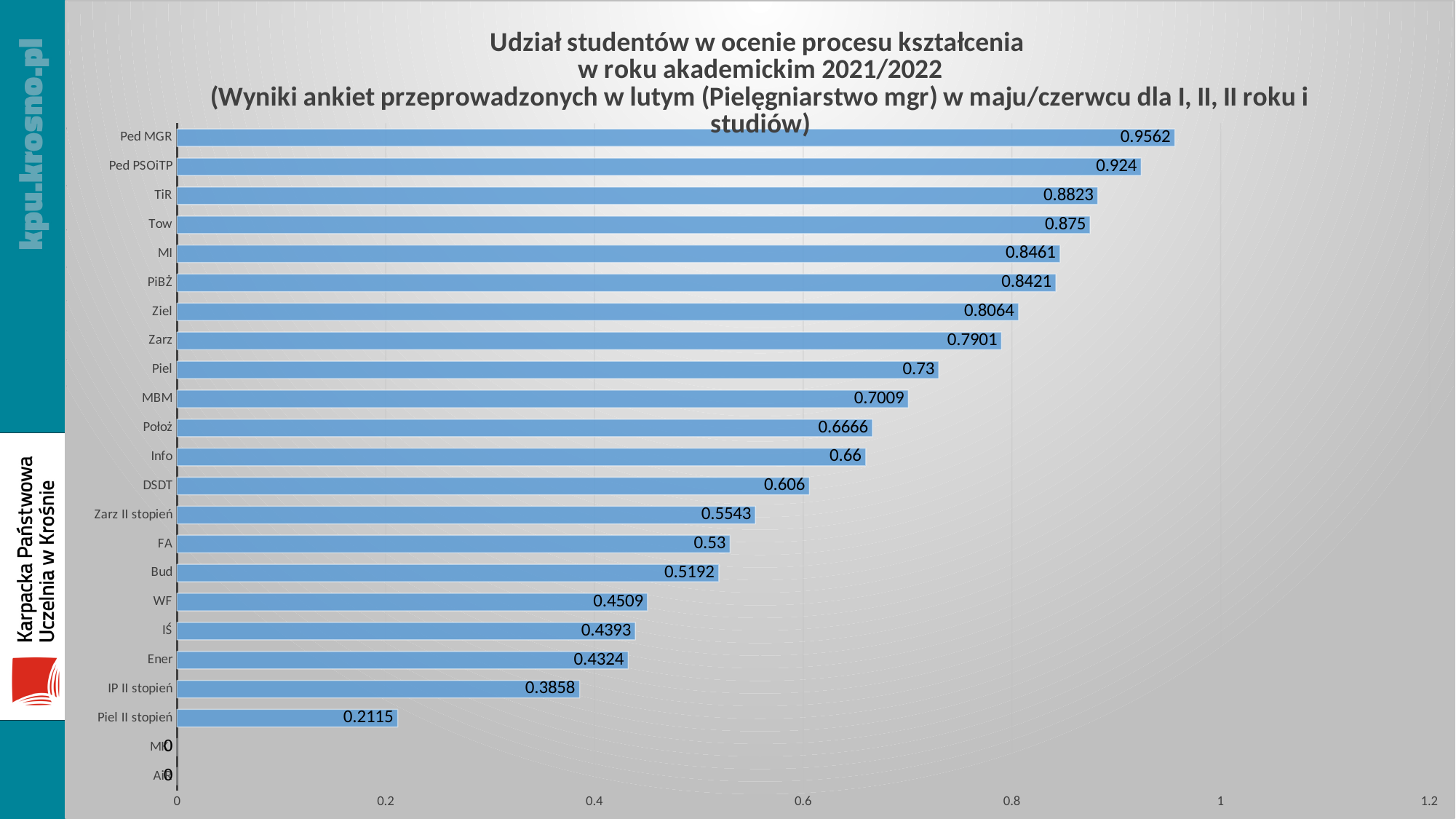
What is the value for Ped MGR? 0.9562 Which category has the highest value? Ped MGR Which is larger, the value for WF or the value for Ener? WF What is the difference between the values for Piel and MBM? 0.0291 What is the value for Piel II stopień? 0.2115 What is the value for Info? 0.66 What is the value for Zarz II stopień? 0.5543 What is the difference between the values for Ped MGR and Ped PSOiTP? 0.0322 Which is larger, the value for Tow or the value for MI? Tow What kind of chart is shown on the slide? bar chart Is the value for Ziel greater or less than 0.8? greater What is the highest value shown on the horizontal axis? 1.2